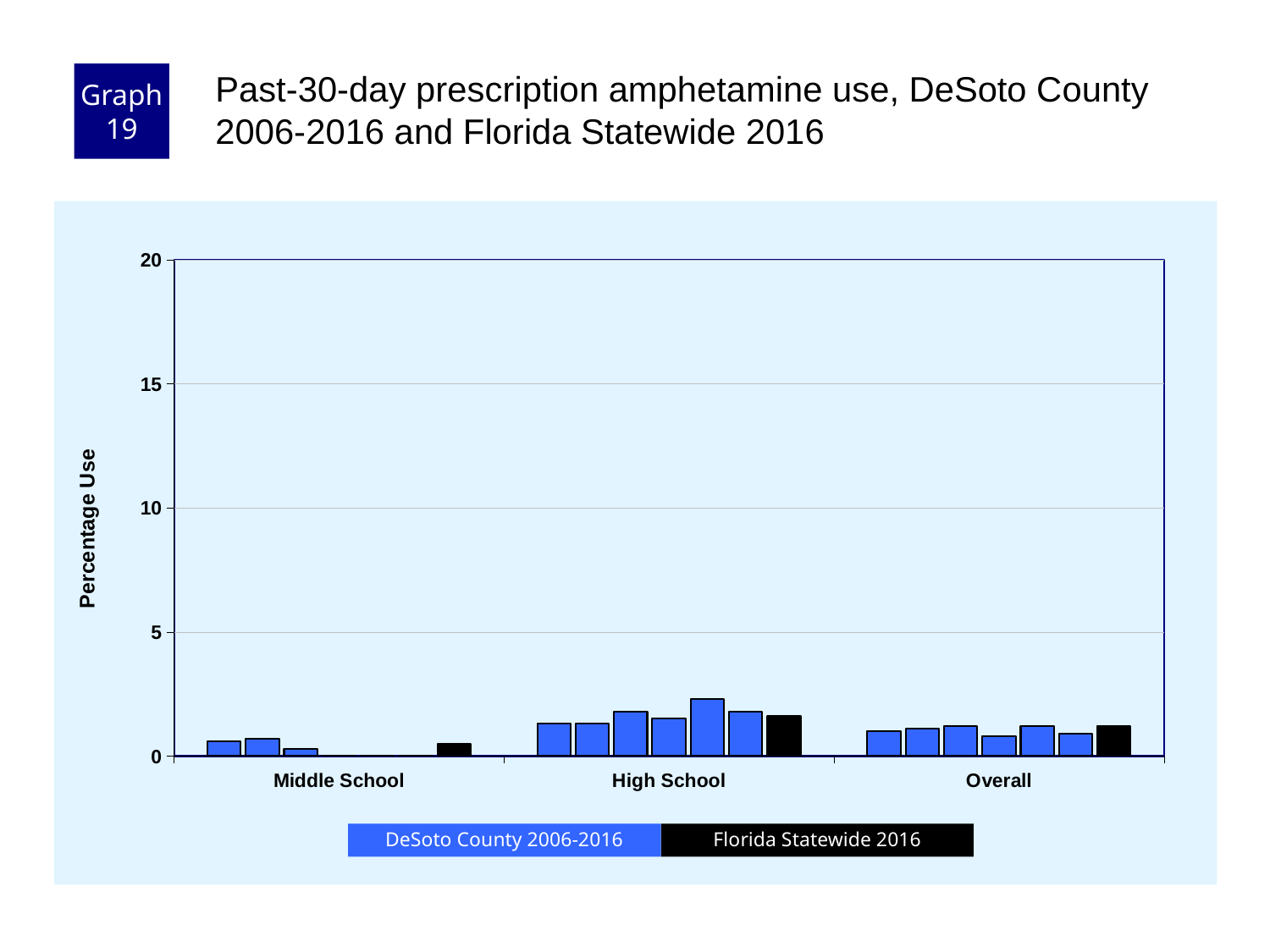
Which category has the tallest bar in the chart? High School Are any of the bars in the chart greater than 5? No How many series does the legend list? 2 Is the Florida Statewide 2016 value for High School greater or less than 5? less What colour are the Florida Statewide 2016 bars? black What kind of chart is shown on the slide? bar chart How many categories are shown on the x axis? 3 Which is larger, the Florida Statewide 2016 value for Overall or for Middle School? Overall What is the label on the y axis? Percentage Use Which is larger, the Florida Statewide 2016 value for High School or for Middle School? High School Is the Florida Statewide 2016 value for Middle School greater or less than 5? less